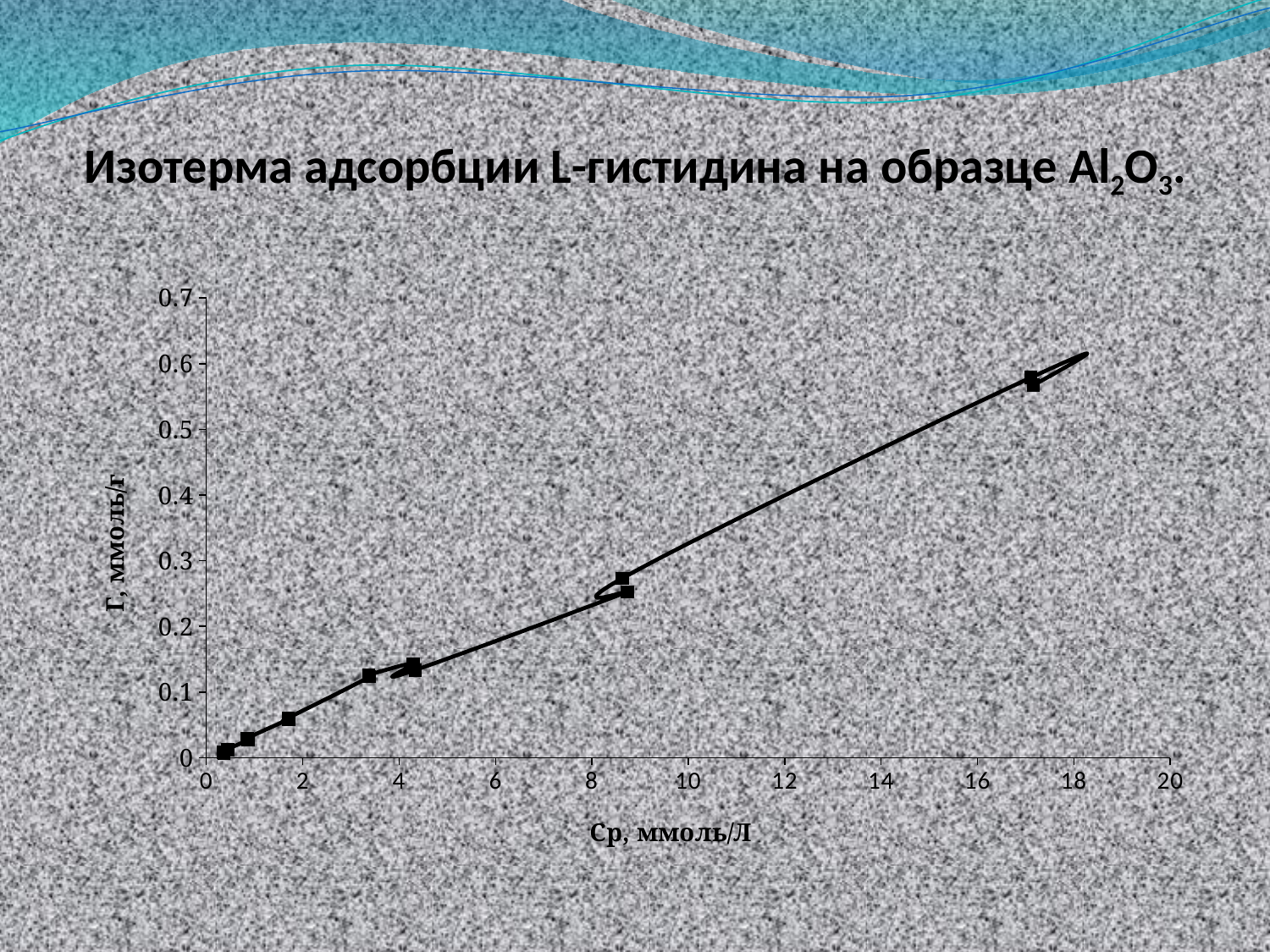
Is the value of Г at the point near Ср = 17 greater or less than 0.5? greater Is the value of Г at the point near Ср = 1.7 greater or less than 0.1? less What kind of chart is shown on the slide? line chart What is the label of the x axis? Ср, ммоль/Л What is the highest tick value shown on the y axis? 0.7 Is the value of Г at the points near Ср = 8.7 greater or less than 0.2? greater Do the values of Г rise or fall as Ср increases along the x axis? rise Which point has the higher Г value: the one near Ср = 4 or the one near Ср = 17? the one near Ср = 17